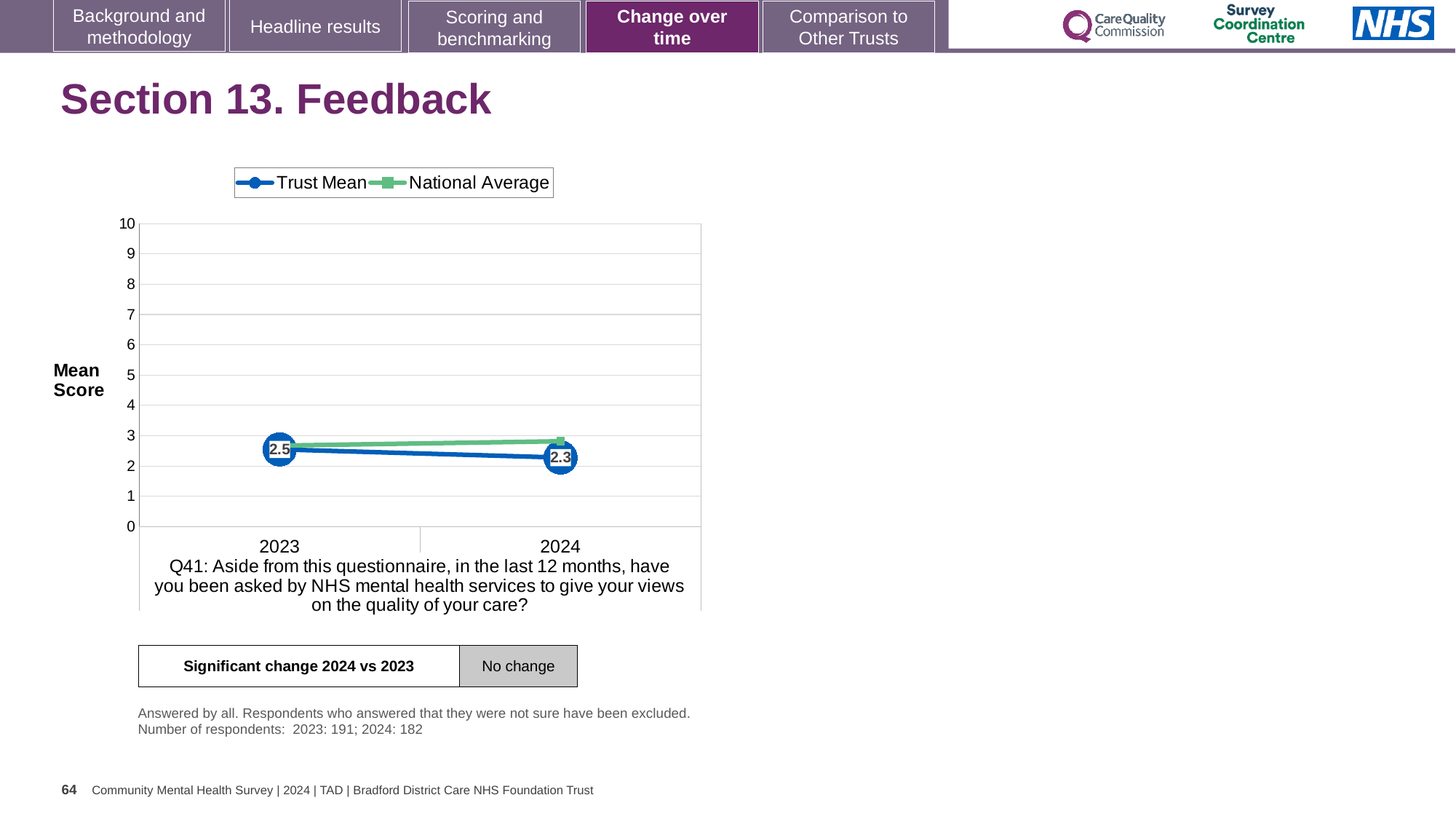
What kind of chart is shown on the slide? line chart Does the Trust Mean rise or fall from 2023 to 2024? fall What is the Trust Mean value for 2023? 2.5 How many series does the legend list? 2 Is the National Average value for 2024 greater or less than 5? less What is the label on the y axis of the chart? Mean Score Which year has the higher Trust Mean, 2023 or 2024? 2023 How many years are plotted on the x axis? 2 What are the two series named in the legend? Trust Mean and National Average In 2024, which is higher, the Trust Mean or the National Average? National Average What is the Trust Mean value for 2024? 2.3 By how much did the Trust Mean change from 2023 to 2024? 0.2